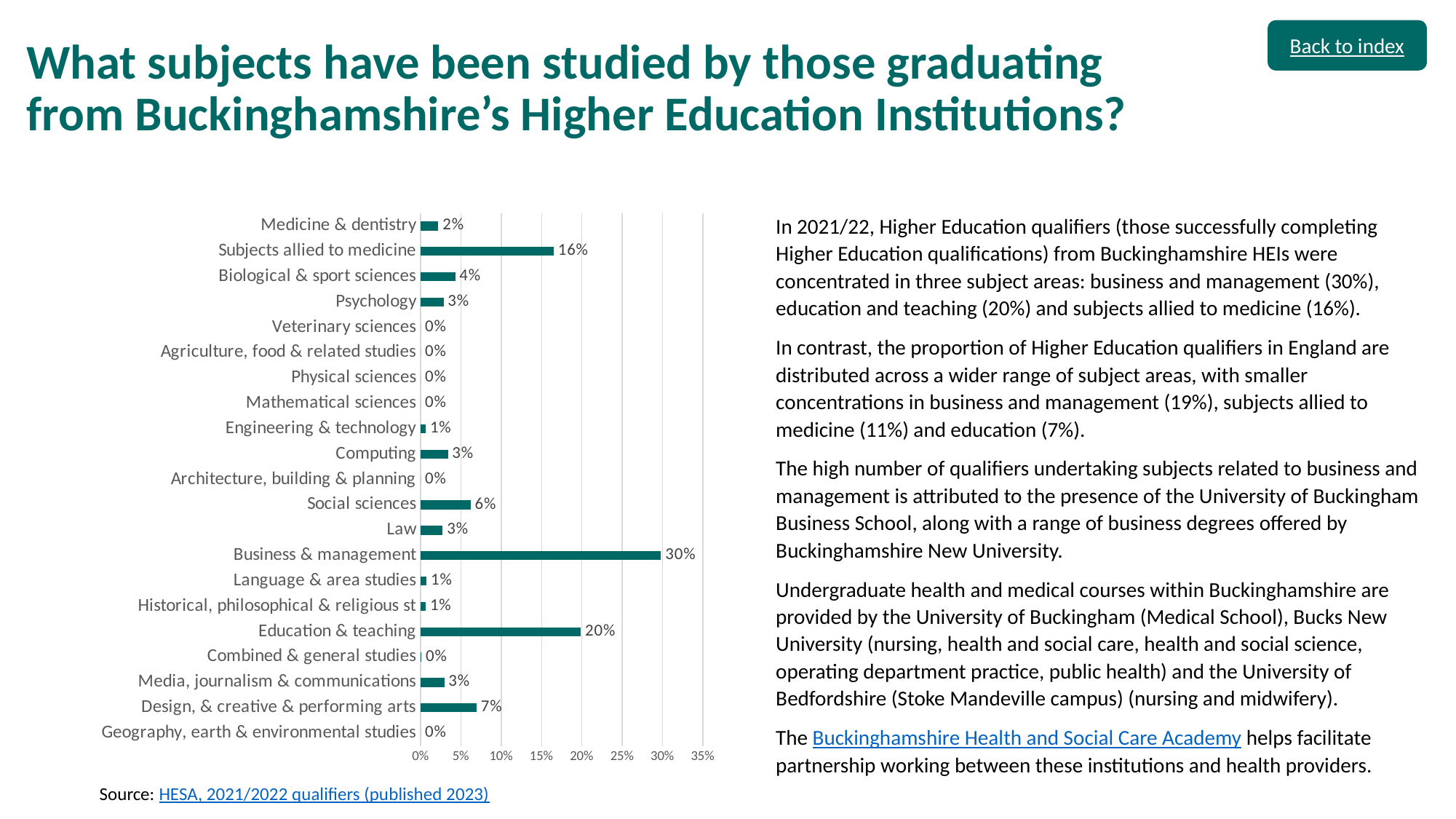
What is the difference between the values for Business & management and Education & teaching? 10% Which is larger, the value for Social sciences or the value for Biological & sport sciences? Social sciences What is the value for Design, & creative & performing arts? 7% What percentage is shown for Subjects allied to medicine? 16% What is the value shown for Medicine & dentistry? 2% What percentage of qualifiers studied Business & management? 30% What type of chart is shown on the slide? Bar chart What is the value shown for Education & teaching? 20% What is the difference between the values for Subjects allied to medicine and Design, & creative & performing arts? 9% How many subject categories are shown on the chart? 21 What is the highest value shown on the x axis of the chart? 35% Which subject area has the highest percentage of qualifiers? Business & management